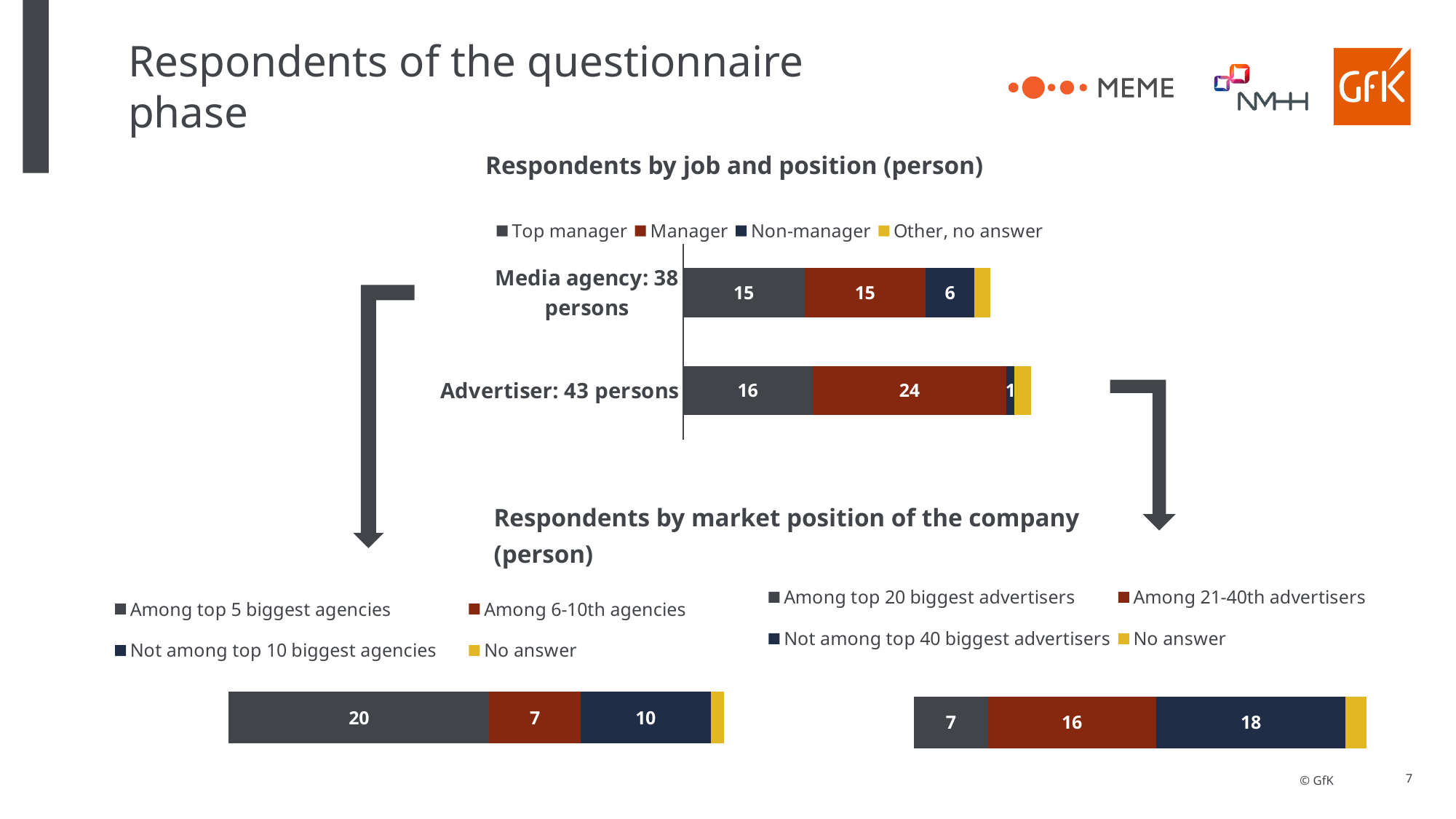
In the 'Respondents by job and position (person)' chart, what is the total number of Advertiser respondents? 43 persons In the 'Respondents by job and position (person)' chart, how many Top managers are among the Media agency respondents? 15 In the bottom-right chart on market position of advertisers, how many respondents are not among the top 40 biggest advertisers? 18 In the bottom-left chart on market position of agencies, how many respondents are among the top 5 biggest agencies? 20 In the 'Respondents by job and position (person)' chart, which group has more Non-managers, Media agency or Advertiser? Media agency In the 'Respondents by job and position (person)' chart, what is the difference between the number of Managers among Advertisers and the number of Managers among Media agency respondents? 9 In the bottom-left chart on market position of agencies, which category has the lowest labelled value? Among 6-10th agencies In the 'Respondents by job and position (person)' chart, how many Managers are among the Advertiser respondents? 24 In the 'Respondents by job and position (person)' chart, how many Non-managers are among the Advertiser respondents? 1 In the bottom-right chart on market position of advertisers, what is the difference between the number among 21-40th advertisers and the number among the top 20 biggest advertisers? 9 What kind of chart is 'Respondents by job and position (person)'? Stacked bar chart In the 'Respondents by job and position (person)' chart, how many series does the legend list? 4